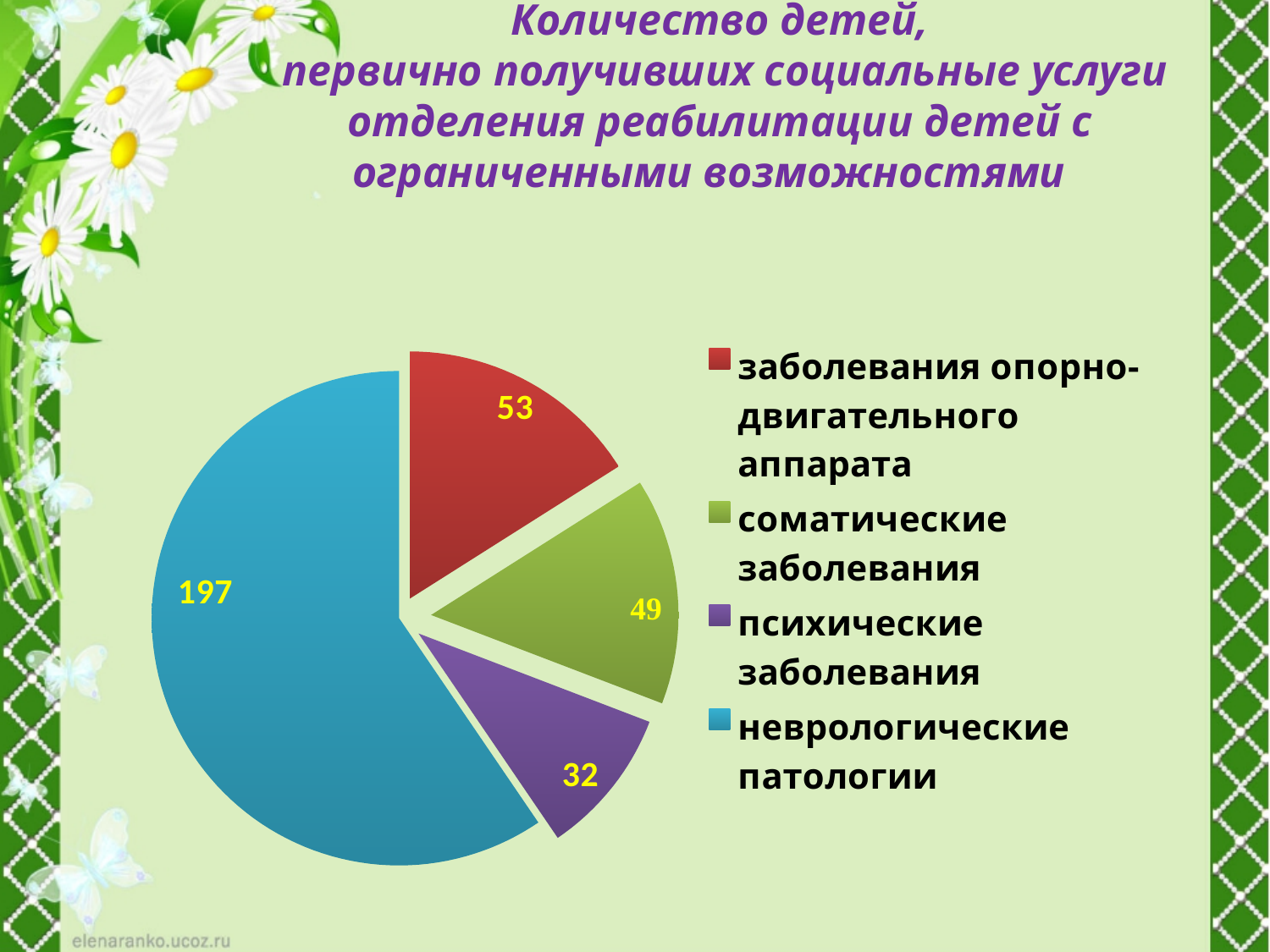
How many slices does the pie chart have? 4 What is the difference between the values for неврологические патологии and заболевания опорно-двигательного аппарата? 144 What kind of chart is shown on the slide? pie chart What is the total of all four slices in the pie chart? 331 What is the value for заболевания опорно-двигательного аппарата? 53 What is the value for психические заболевания? 32 What is the value for неврологические патологии? 197 What colour is the slice for неврологические патологии? blue Which category has the smallest slice of the pie? психические заболевания Which category has the largest slice of the pie? неврологические патологии What is the value for соматические заболевания? 49 Which is larger: the value for соматические заболевания or the value for психические заболевания? соматические заболевания